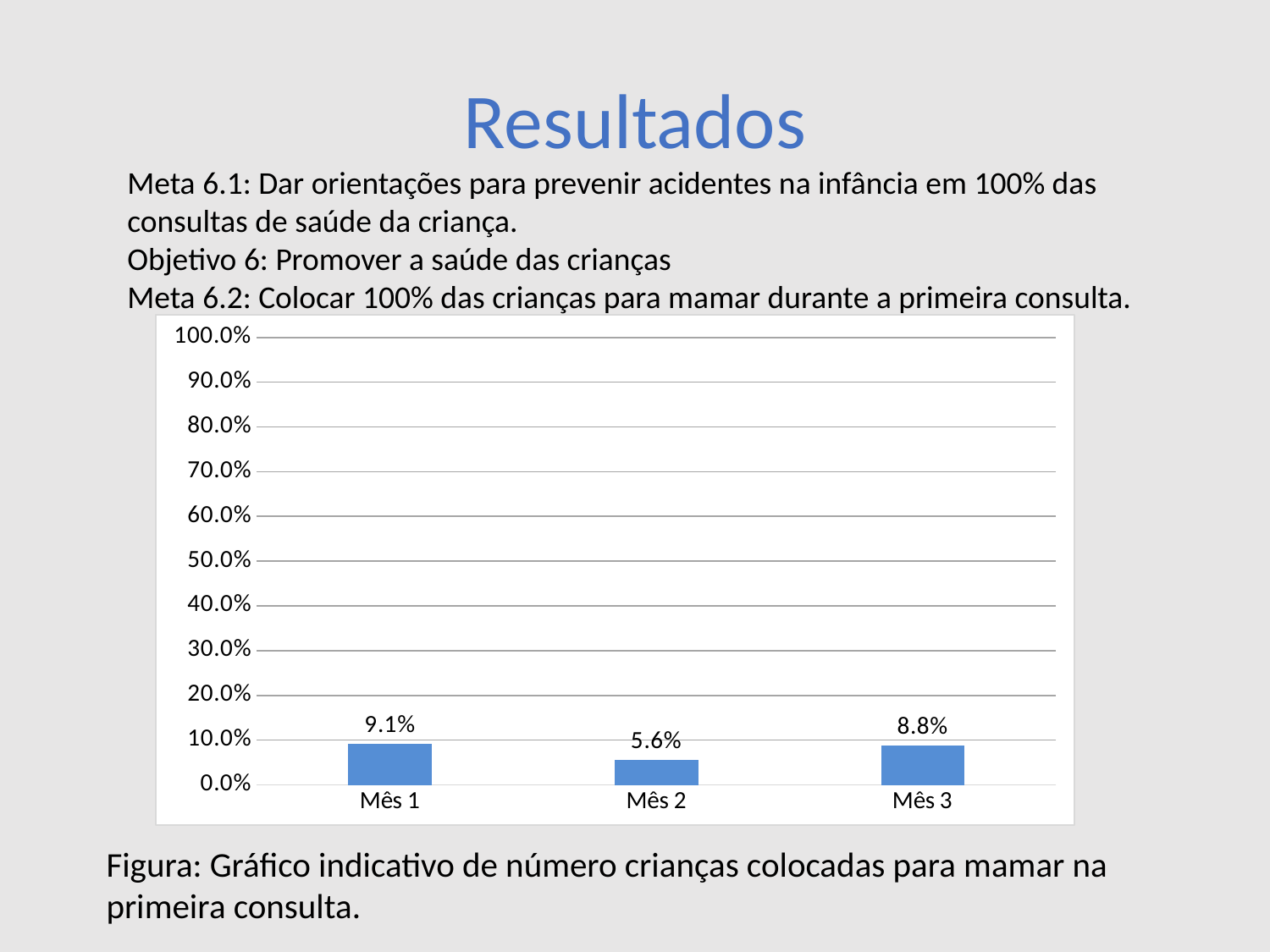
Which month has the lowest value? Mês 2 How many months are shown on the chart? 3 What is the value for Mês 2? 5.6% What is the value for Mês 3? 8.8% What is the difference between the values for Mês 3 and Mês 2? 3.2% What kind of chart is shown on the slide? bar chart Which month has the highest value? Mês 1 Which is larger, the value for Mês 2 or the value for Mês 3? Mês 3 What is the difference between the values for Mês 1 and Mês 2? 3.5% Is the value for Mês 1 greater or less than 10.0%? less What is the highest value shown on the vertical axis? 100.0% What is the value for Mês 1? 9.1%